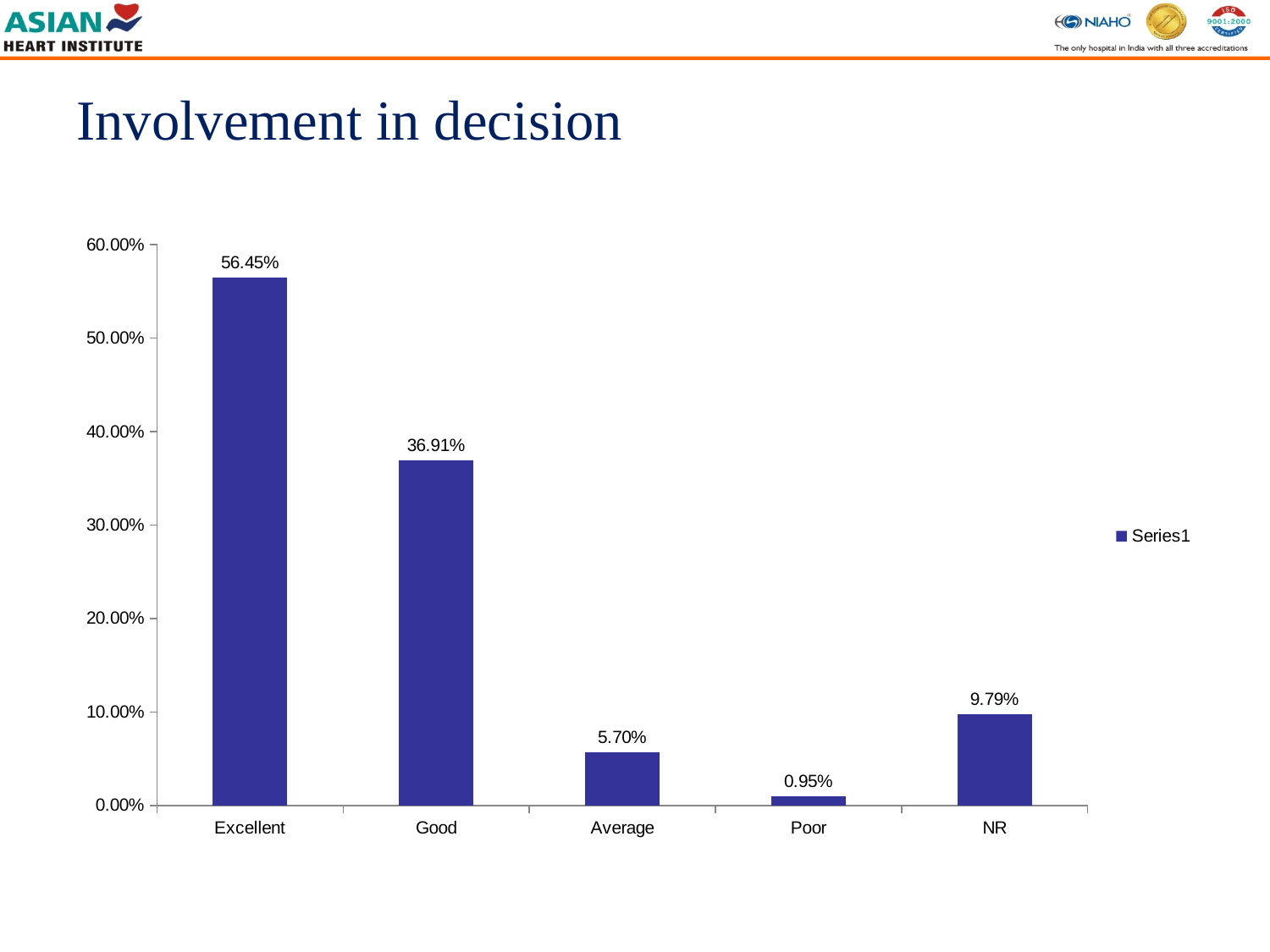
What is the difference between the values for Excellent and Good? 19.54% What is the value for Excellent? 56.45% Which category has the highest value? Excellent Which category has the lowest value? Poor What is the title of the slide? Involvement in decision What is the value for NR? 9.79% Which is larger, the value for Average or the value for NR? NR How many categories are shown on the x axis? 5 How many series does the legend list? 1 What is the value for Good? 36.91% Is the value for Good greater or less than 40.00%? less What kind of chart is shown on the slide? bar chart